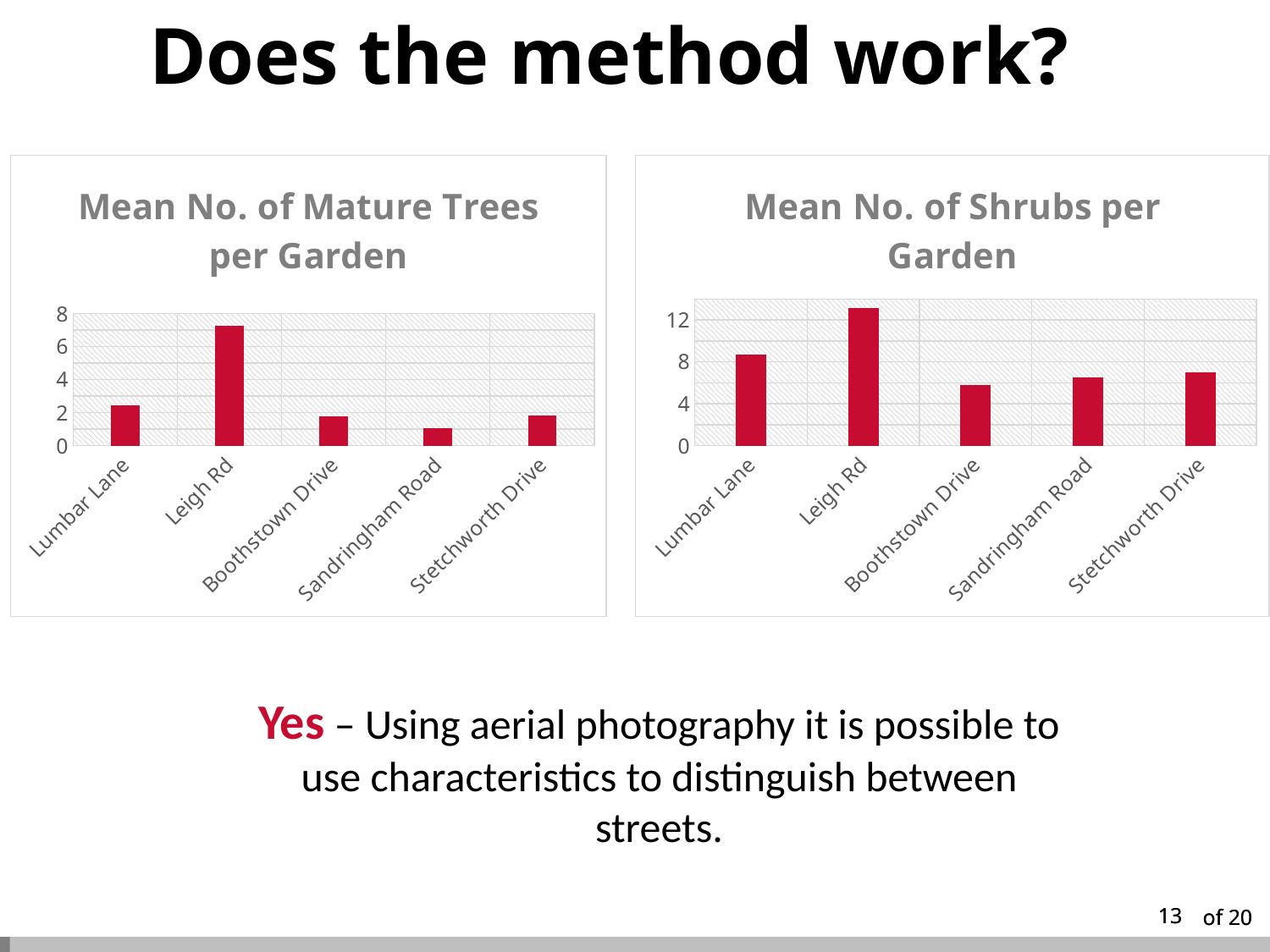
In the 'Mean No. of Mature Trees per Garden' chart, which is larger, the value for Lumbar Lane or the value for Sandringham Road? Lumbar Lane In the 'Mean No. of Mature Trees per Garden' chart, is the value for Lumbar Lane greater or less than 4? less What type of chart is the 'Mean No. of Mature Trees per Garden' chart? Bar chart In the 'Mean No. of Mature Trees per Garden' chart, which street has the lowest value? Sandringham Road In the 'Mean No. of Shrubs per Garden' chart, is the value for Leigh Rd greater or less than 12? greater How many streets are shown in the 'Mean No. of Shrubs per Garden' chart? 5 In the 'Mean No. of Shrubs per Garden' chart, which is larger, the value for Lumbar Lane or the value for Boothstown Drive? Lumbar Lane In the 'Mean No. of Shrubs per Garden' chart, is the value for Lumbar Lane greater or less than 8? greater In the 'Mean No. of Shrubs per Garden' chart, which street has the highest value? Leigh Rd In the 'Mean No. of Mature Trees per Garden' chart, which street has the highest value? Leigh Rd In the 'Mean No. of Shrubs per Garden' chart, which street has the lowest value? Boothstown Drive